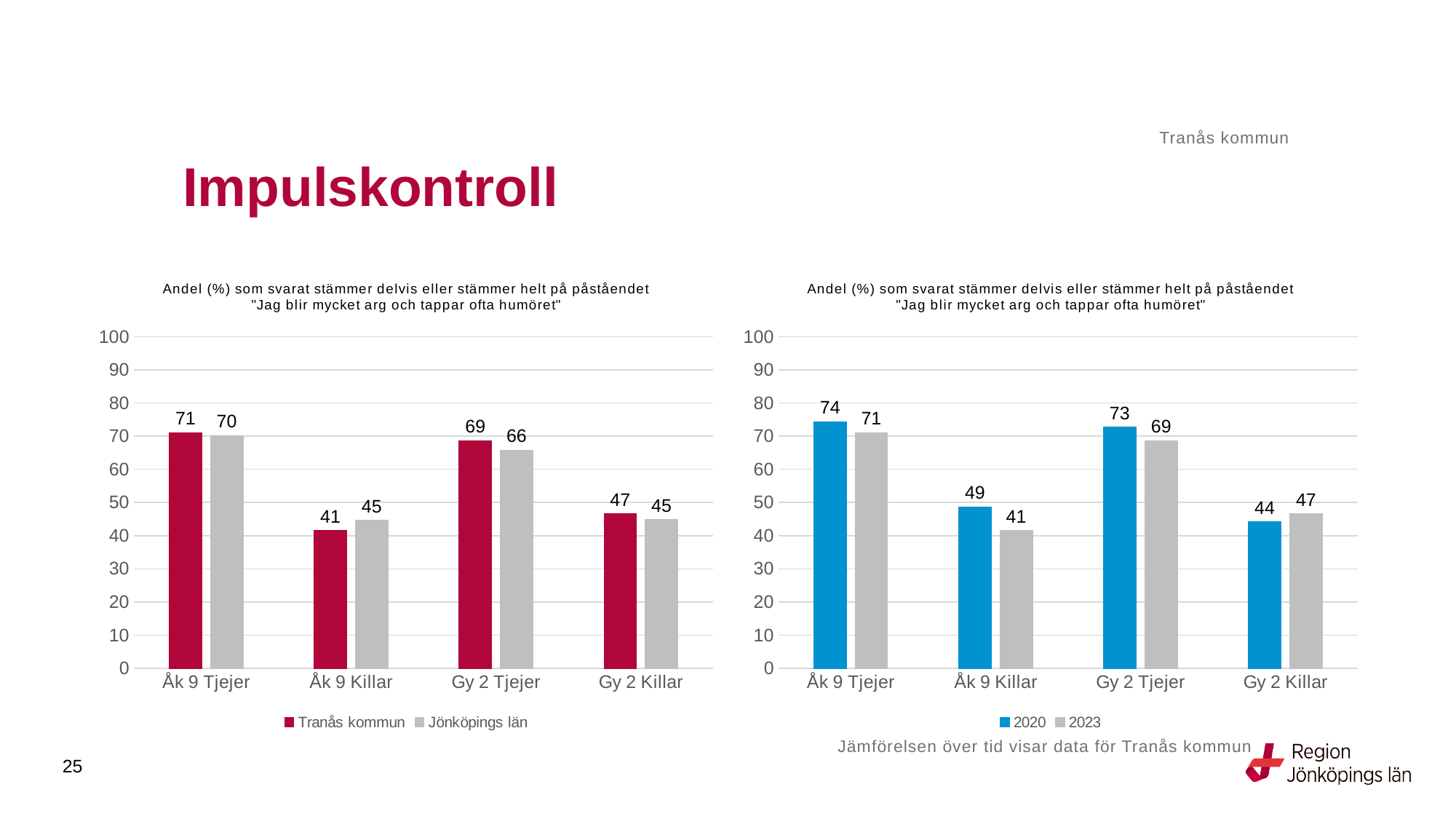
What kind of chart is the right chart? Bar chart In the left chart, what is the value for Jönköpings län for Gy 2 Tjejer? 66 In the right chart, how many categories are shown on the x axis? 4 In the right chart, what is the difference between 2020 and 2023 for Åk 9 Killar? 8 In the right chart, which is larger for Gy 2 Tjejer, 2020 or 2023? 2020 In the left chart, what is the difference between Tranås kommun and Jönköpings län for Gy 2 Killar? 2 In the left chart, which category has the highest value for Tranås kommun? Åk 9 Tjejer In the left chart, what is the value for Tranås kommun for Åk 9 Killar? 41 In the left chart, how many series does the legend list? 2 In the right chart, what is the value for 2023 for Gy 2 Killar? 47 In the right chart, what is the value for 2020 for Åk 9 Killar? 49